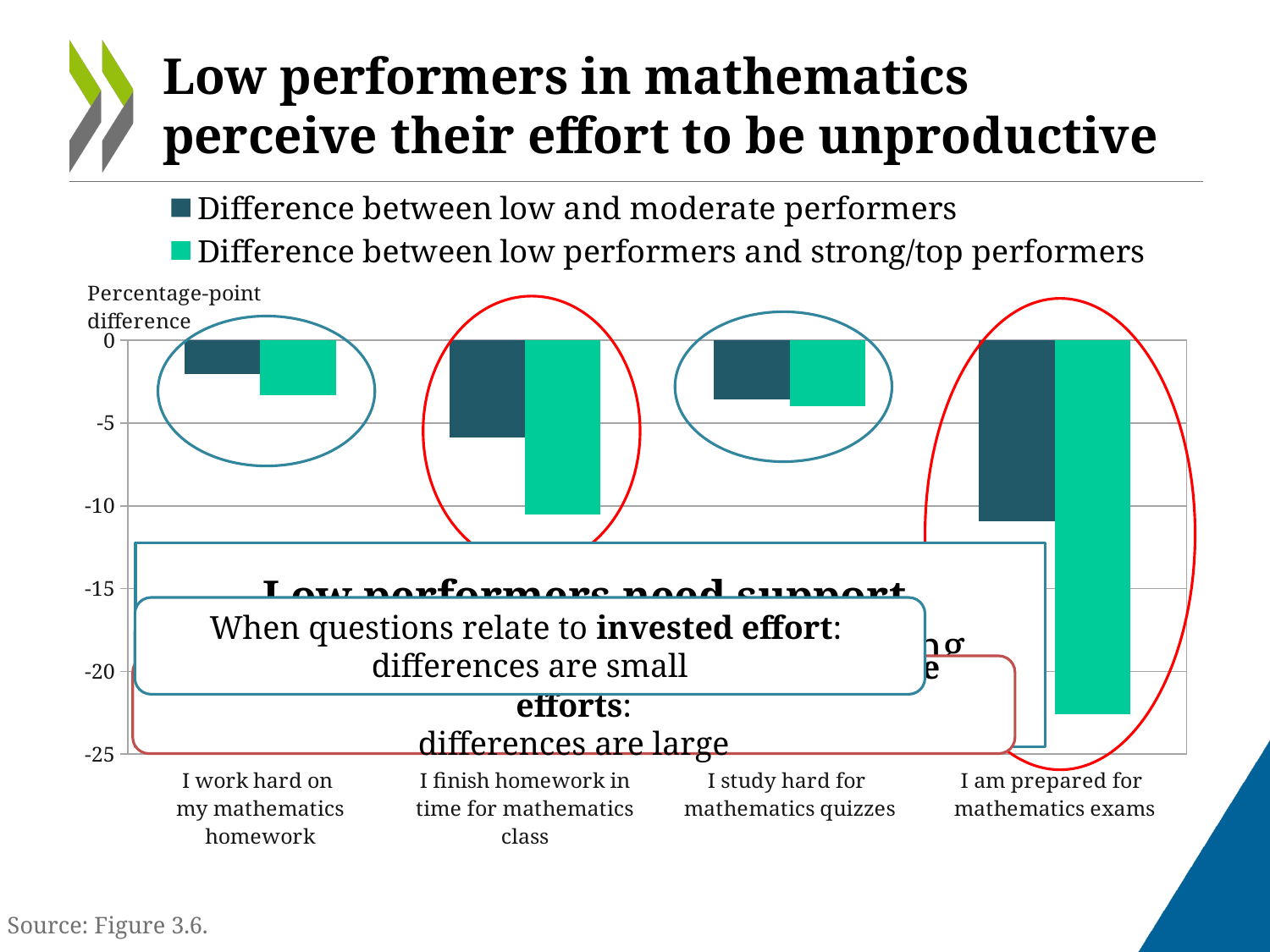
How many series does the chart's legend list? 2 Which series is shown in dark teal in the chart's legend? Difference between low and moderate performers What is the label on the vertical axis of the chart? Percentage-point difference Is the value for 'Difference between low and moderate performers' for 'I am prepared for mathematics exams' greater or less than -10? less Is the value for 'Difference between low performers and strong/top performers' for 'I am prepared for mathematics exams' greater or less than -20? less What kind of chart is shown on the slide? Bar chart Which category shows the largest (most negative) difference between low performers and strong/top performers? I am prepared for mathematics exams Is the value for 'Difference between low performers and strong/top performers' for 'I study hard for mathematics quizzes' greater or less than -5? greater How many categories (statements) are shown on the x axis of the chart? 4 For the 'Difference between low performers and strong/top performers' series, which is more negative: 'I am prepared for mathematics exams' or 'I study hard for mathematics quizzes'? I am prepared for mathematics exams Which category shows the largest (most negative) difference between low and moderate performers? I am prepared for mathematics exams